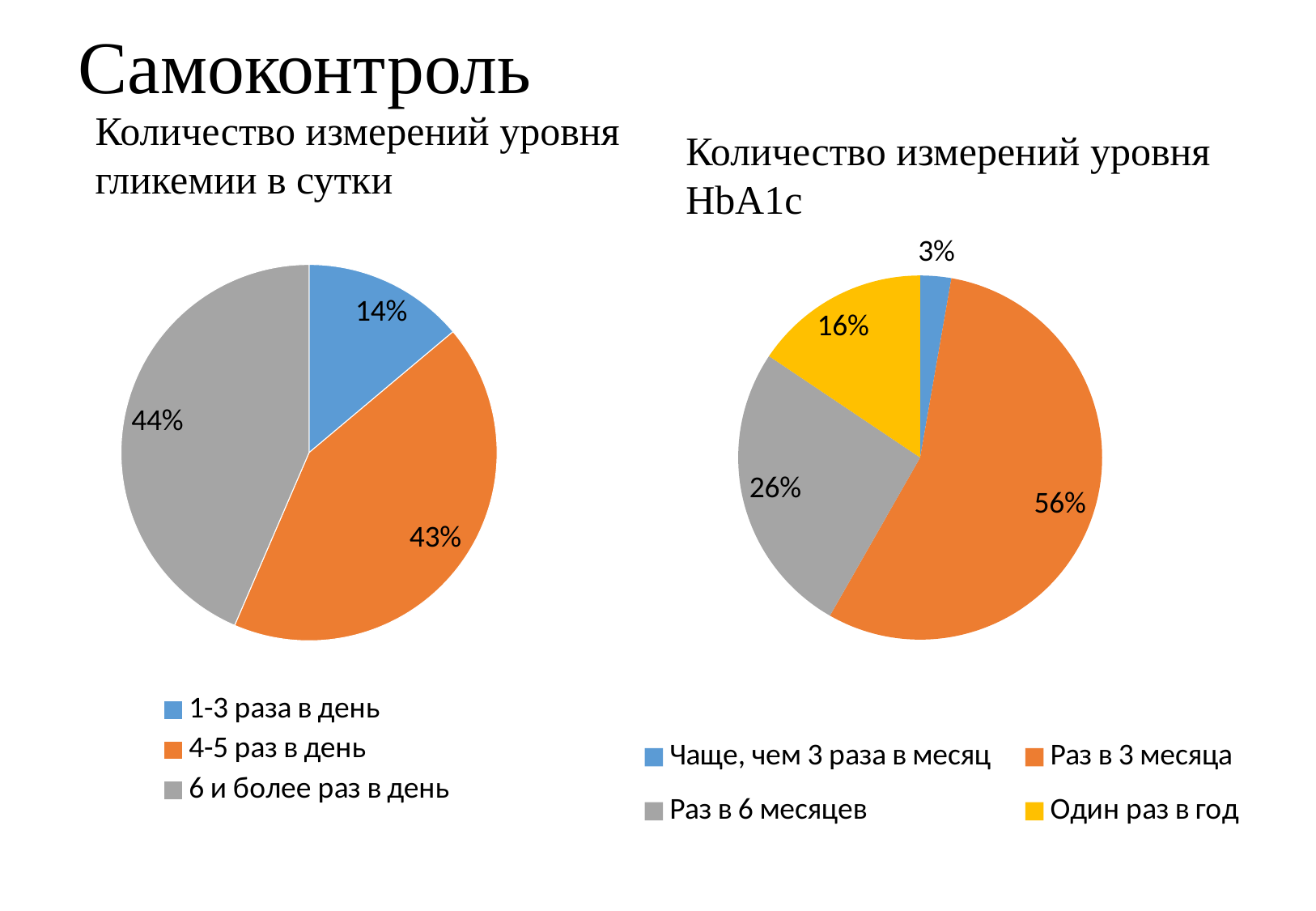
In the right chart (Количество измерений уровня HbA1c), what colour is the slice for 'Один раз в год'? Yellow In the right chart (Количество измерений уровня HbA1c), what share is shown for 'Один раз в год'? 16% In the left chart (Количество измерений уровня гликемии в сутки), what share is shown for '1-3 раза в день'? 14% In the left chart (Количество измерений уровня гликемии в сутки), what share is shown for '4-5 раз в день'? 43% In the right chart (Количество измерений уровня HbA1c), which category has the smallest share? Чаще, чем 3 раза в месяц In the left chart (Количество измерений уровня гликемии в сутки), what is the difference between the shares for '6 и более раз в день' and '1-3 раза в день'? 30% In the left chart (Количество измерений уровня гликемии в сутки), which category has the largest share? 6 и более раз в день In the right chart (Количество измерений уровня HbA1c), how many categories does the legend list? 4 In the left chart (Количество измерений уровня гликемии в сутки), how many categories does the legend list? 3 In the right chart (Количество измерений уровня HbA1c), what share is shown for 'Раз в 3 месяца'? 56% What type of chart is used on the left side of the slide (Количество измерений уровня гликемии в сутки)? Pie chart In the right chart (Количество измерений уровня HbA1c), which is larger: the share for 'Раз в 6 месяцев' or for 'Один раз в год'? Раз в 6 месяцев